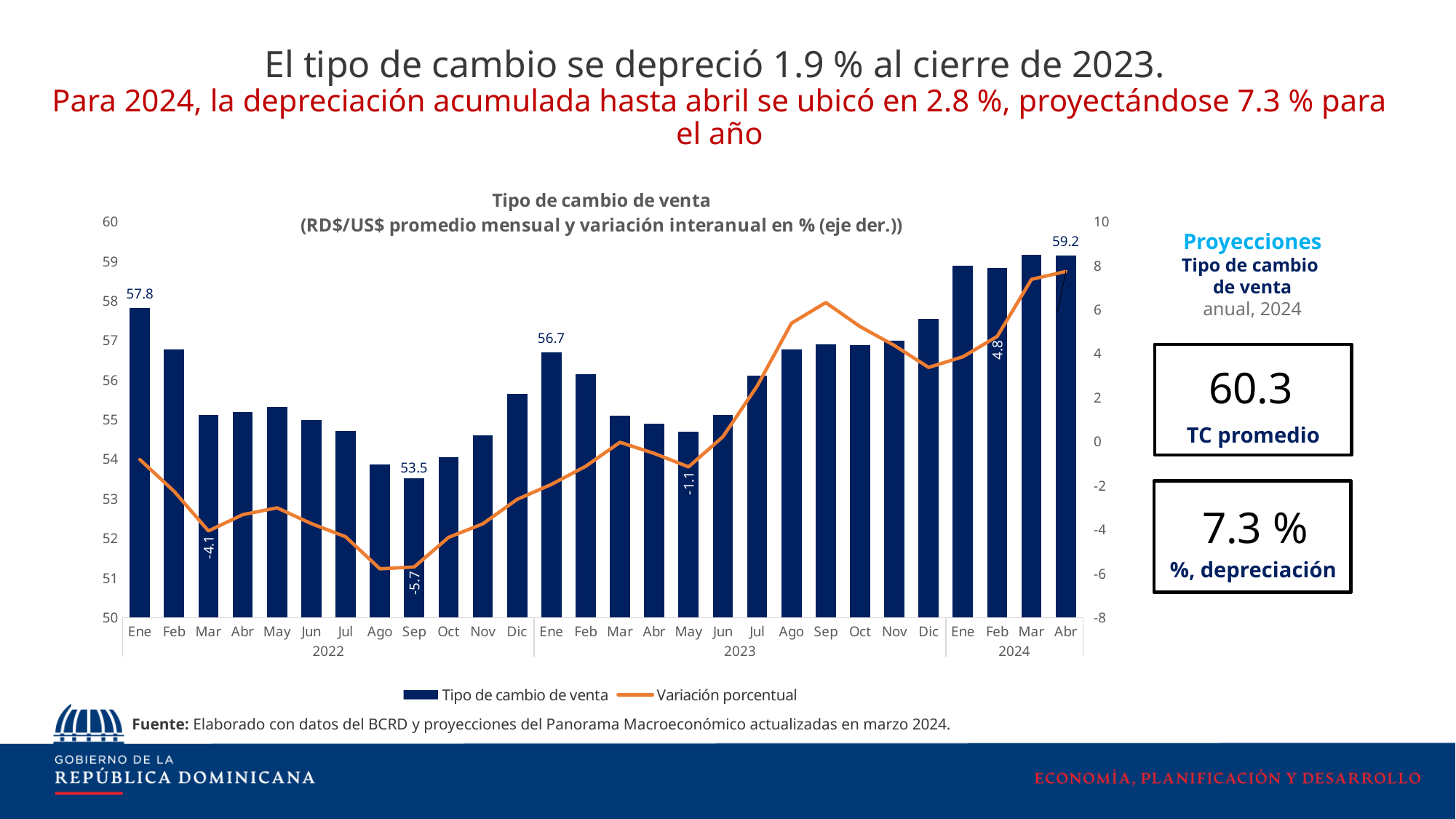
What is the Variación porcentual value labelled for Sep 2022? -5.7 What is the difference between the Tipo de cambio de venta values for Abr 2024 and Ene 2022? 1.4 What is the value of the Tipo de cambio de venta bar for Sep 2022? 53.5 How many series does the legend list? 2 How many monthly bars are plotted in the chart? 28 What is the value of the Tipo de cambio de venta bar for Ene 2022? 57.8 What is the value of the Tipo de cambio de venta bar for Abr 2024? 59.2 What is the Variación porcentual value labelled for Feb 2024? 4.8 Which is larger, the Tipo de cambio de venta for Ene 2023 or for Sep 2022? Ene 2023 Is the Tipo de cambio de venta bar for Ago 2022 greater or less than 54? less What colour is the Variación porcentual line? orange Does the Tipo de cambio de venta generally rise or fall from Ene 2023 to Abr 2024? rise